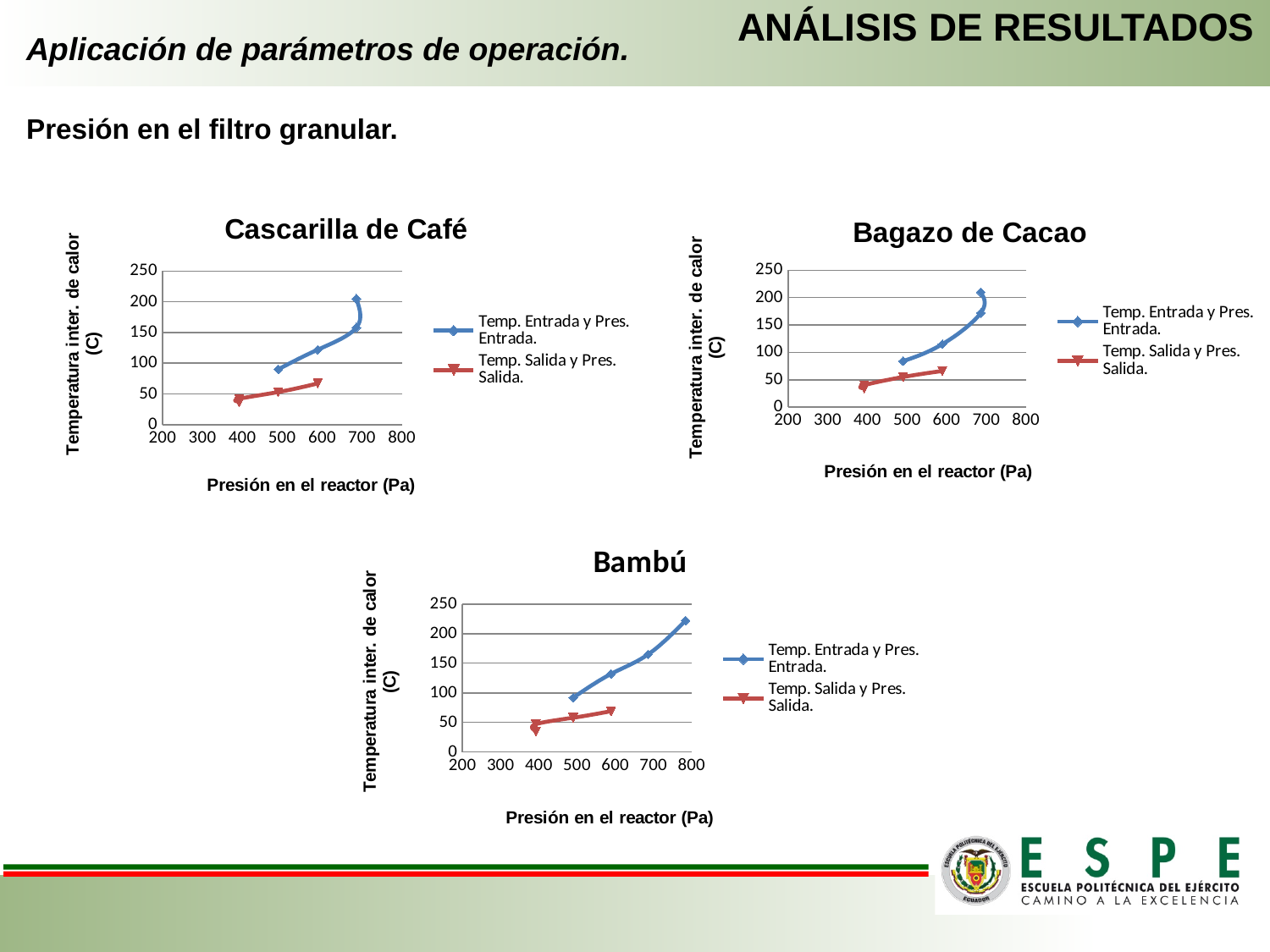
In the "Bagazo de Cacao" chart, does the "Temp. Salida y Pres. Salida." series rise or fall as pressure increases along the x axis? rise In the "Cascarilla de Café" chart, is the lowest value of the "Temp. Salida y Pres. Salida." series greater or less than 50? less What is the x-axis label of the "Bambú" chart? Presión en el reactor (Pa) In the "Bagazo de Cacao" chart, which series reaches higher temperatures, "Temp. Entrada y Pres. Entrada." or "Temp. Salida y Pres. Salida."? Temp. Entrada y Pres. Entrada. In the "Cascarilla de Café" chart, is the highest value of the "Temp. Entrada y Pres. Entrada." series greater or less than 150? greater What colour is the "Temp. Salida y Pres. Salida." series in the "Bagazo de Cacao" chart? red What kind of chart is the "Cascarilla de Café" chart? line chart In the "Bambú" chart, is the highest value of the "Temp. Entrada y Pres. Entrada." series greater or less than 200? greater How many series does the legend of the "Bambú" chart list? 2 How many charts are shown on the slide? 3 In the "Bambú" chart, does the "Temp. Entrada y Pres. Entrada." series rise or fall as pressure increases along the x axis? rise